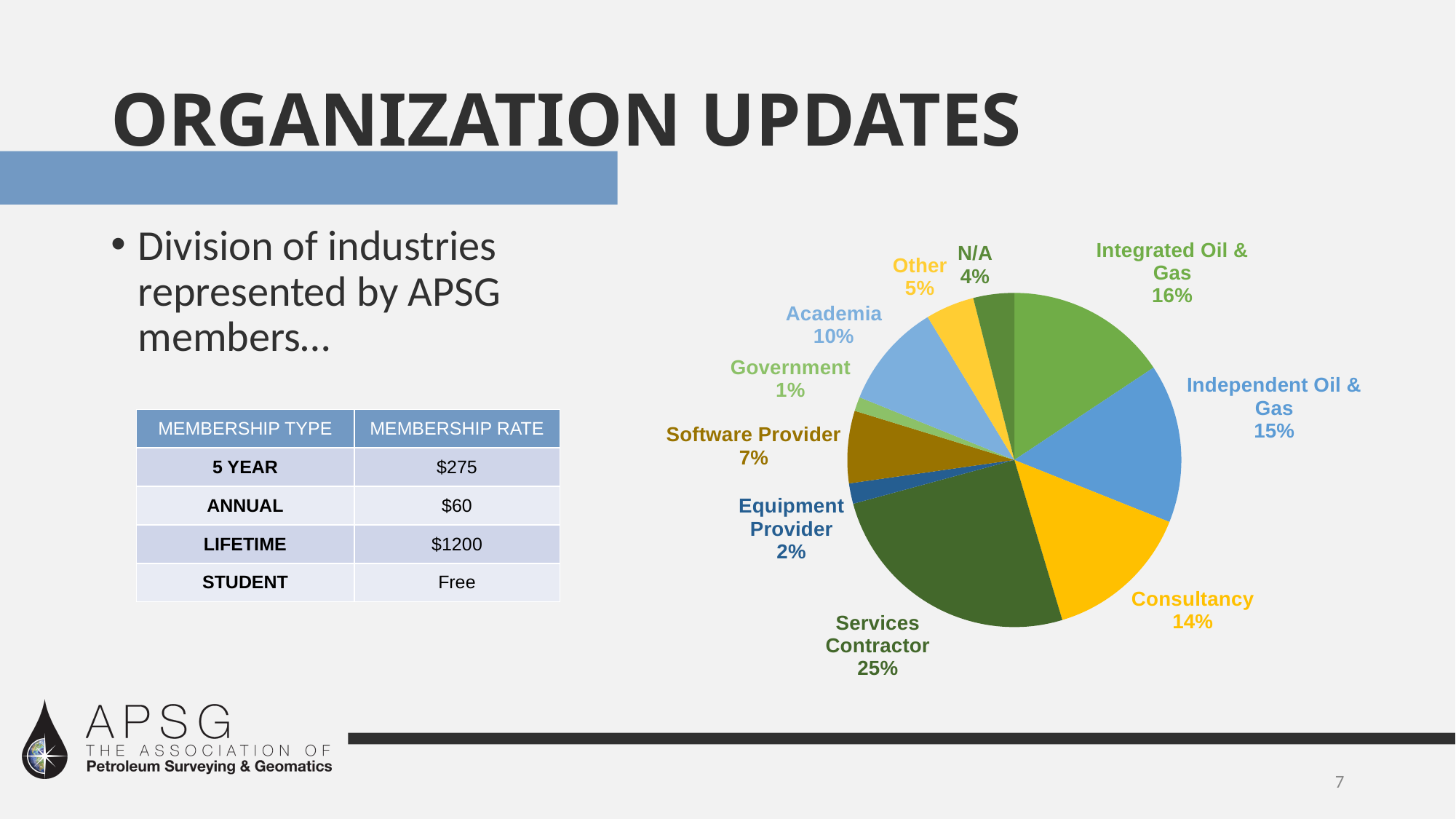
What share of members is labelled N/A? 4% Which industry has the largest share of APSG members? Services Contractor What percentage of members are in Integrated Oil & Gas? 16% What kind of chart is shown on the slide? Pie chart What share of APSG members are Services Contractors? 25% What is the difference in percentage points between Services Contractor and Consultancy? 11 Which has a larger share, Software Provider or Academia? Academia How many slices does the pie chart have? 10 What is the combined share of Integrated Oil & Gas and Independent Oil & Gas? 31% What percentage of members are in Academia? 10% Which industry has the smallest share of APSG members? Government What share of members are Equipment Providers? 2%